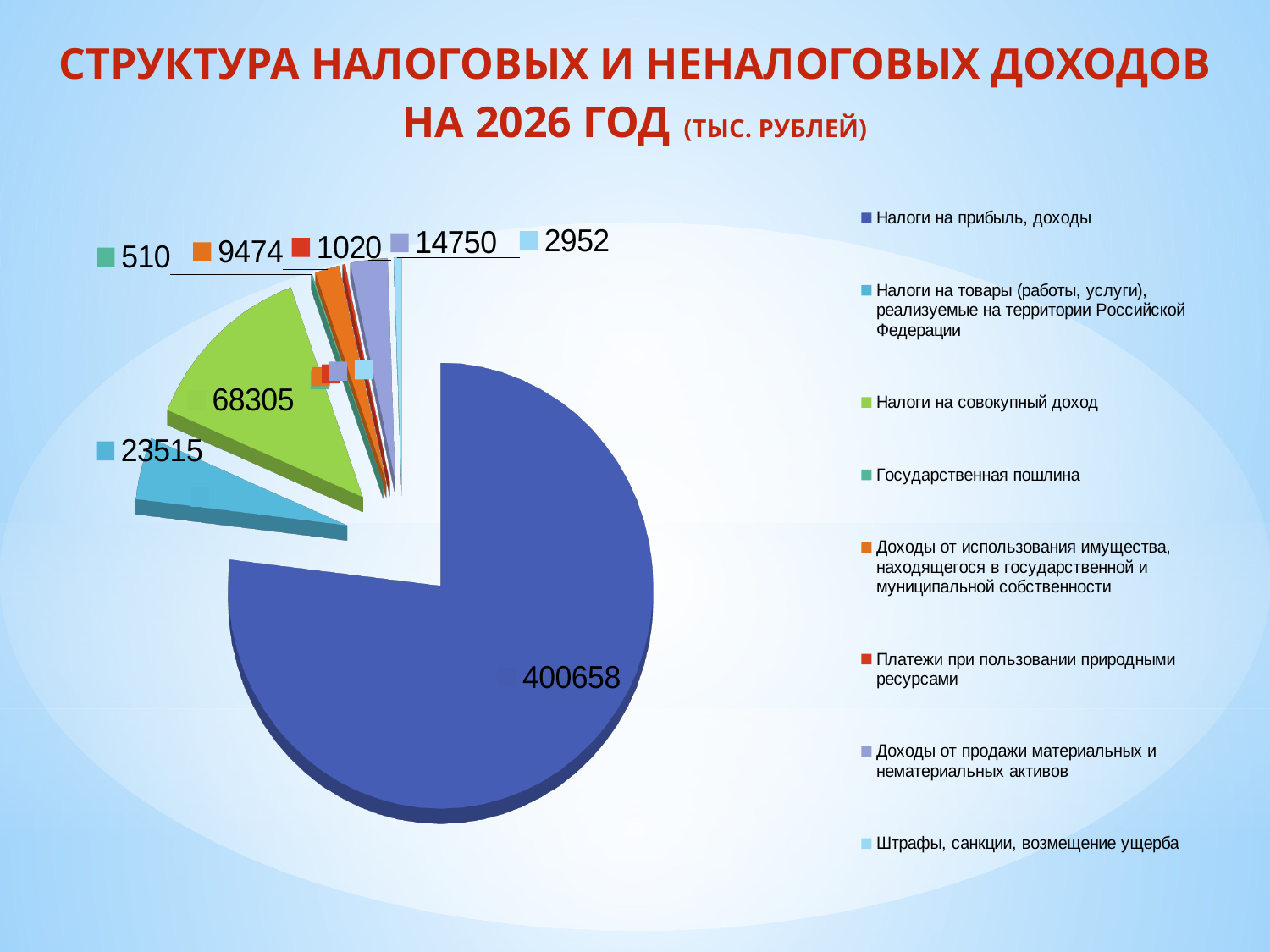
What is the value for Доходы от продажи материальных и нематериальных активов? 14750 What type of chart is shown on the slide? Pie chart How many categories does the pie chart have? 8 Which is larger: the value for Доходы от использования имущества or the value for Штрафы, санкции, возмещение ущерба? Доходы от использования имущества What is the value for Налоги на совокупный доход? 68305 Which category has the largest slice of the pie? Налоги на прибыль, доходы Which category has the smallest slice of the pie? Государственная пошлина What is the value for Налоги на прибыль, доходы? 400658 What unit is stated in the chart title? тыс. рублей What is the total of all slices in the pie chart? 521184 What is the value for Государственная пошлина? 510 What is the difference between the values for Налоги на совокупный доход and Налоги на товары (работы, услуги), реализуемые на территории Российской Федерации? 44790